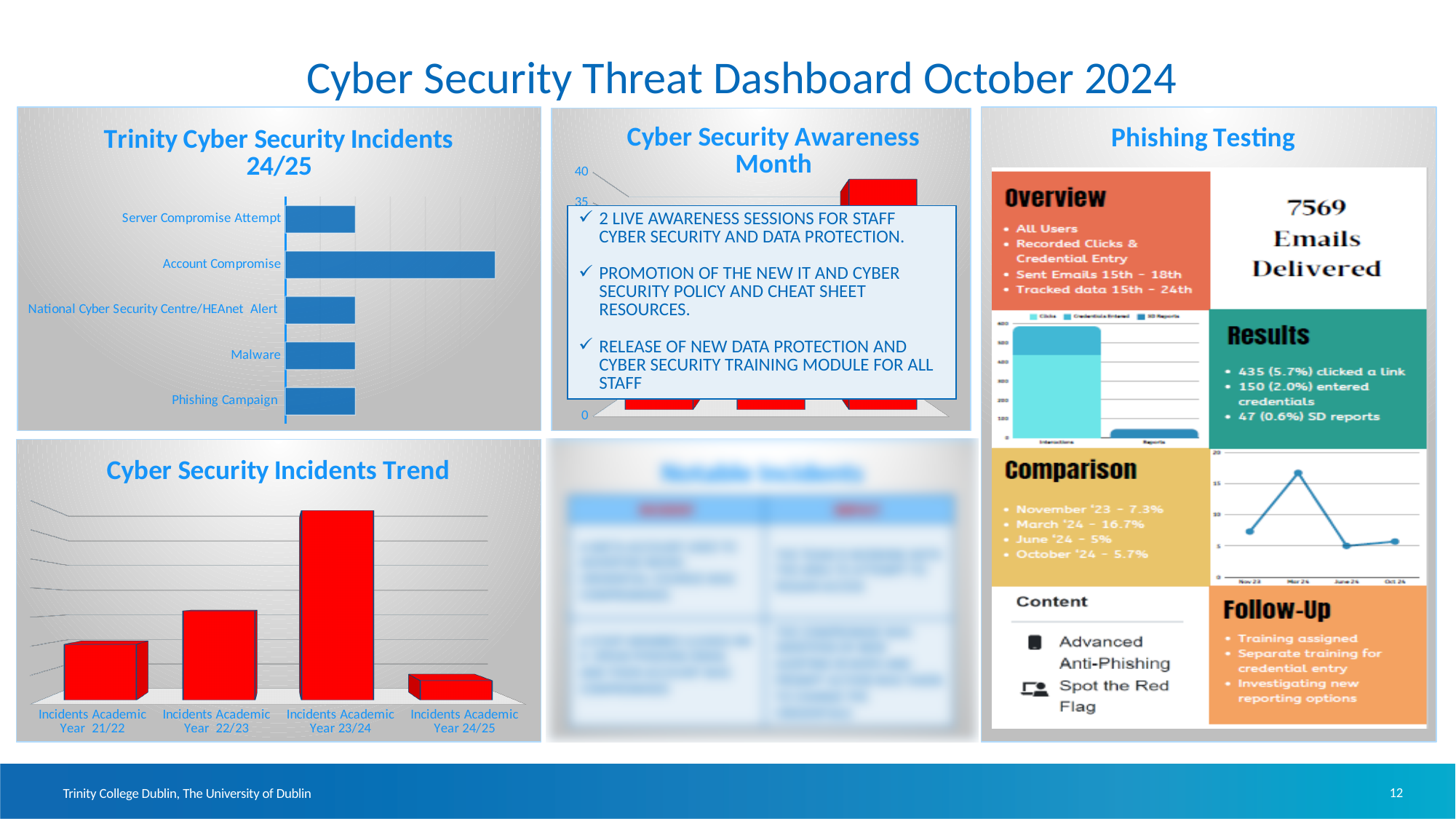
In the 'Cyber Security Incidents Trend' chart, which is larger: Incidents Academic Year 22/23 or Incidents Academic Year 21/22? Incidents Academic Year 22/23 In the 'Cyber Security Incidents Trend' chart, which academic year has the highest number of incidents? Incidents Academic Year 23/24 What kind of chart is the 'Trinity Cyber Security Incidents 24/25' chart? Bar chart What kind of chart is the 'Cyber Security Incidents Trend' chart? Bar chart In the 'Phishing Testing' panel's line chart, which month has the highest value? Mar 24 What colour are the bars in the 'Cyber Security Incidents Trend' chart? Red In the 'Cyber Security Incidents Trend' chart, which academic year has the lowest number of incidents? Incidents Academic Year 24/25 In the 'Trinity Cyber Security Incidents 24/25' chart, which category has the highest value? Account Compromise How many categories are shown in the 'Trinity Cyber Security Incidents 24/25' chart? 5 How many academic years are shown in the 'Cyber Security Incidents Trend' chart? 4 What is the title of the bar chart in the bottom-left panel of the slide? Cyber Security Incidents Trend In the 'Trinity Cyber Security Incidents 24/25' chart, which is larger: Account Compromise or Malware? Account Compromise